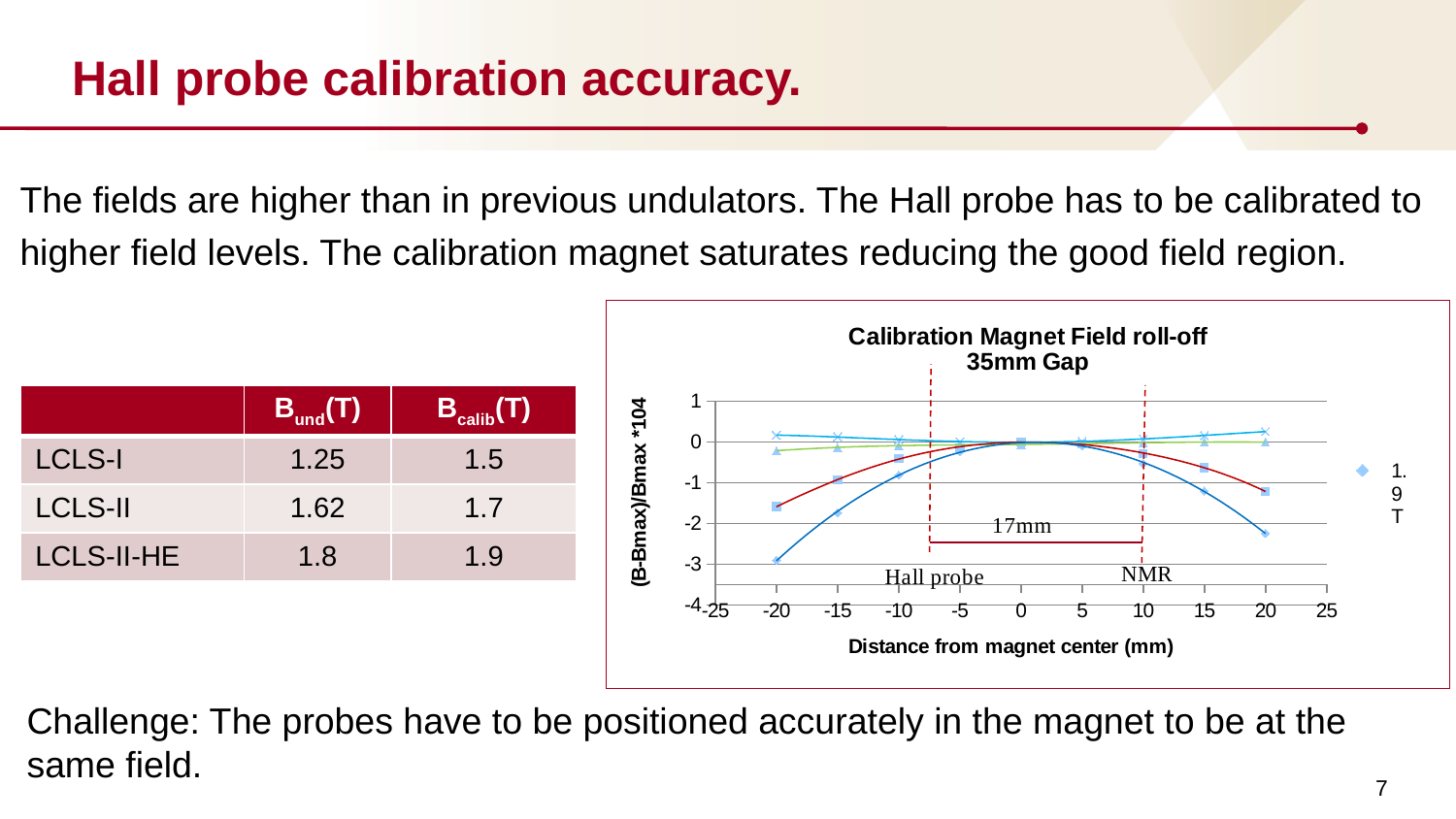
Is the value of the red series at -20 mm greater or less than -2? greater Is the value of the red series at 20 mm greater or less than -1? less At -20 mm, which series has the lower value, the dark blue series or the red series? the dark blue series Is the value of the light blue series at 20 mm greater or less than 0? greater What is the label of the x axis of the chart? Distance from magnet center (mm) Which series reaches the lowest value on the chart? the dark blue series How many data points does each series have along the x axis? 9 What is the lowest value shown on the y axis of the chart? -4 What kind of chart is shown on the slide? line chart What is the title of the chart? Calibration Magnet Field roll-off 35mm Gap